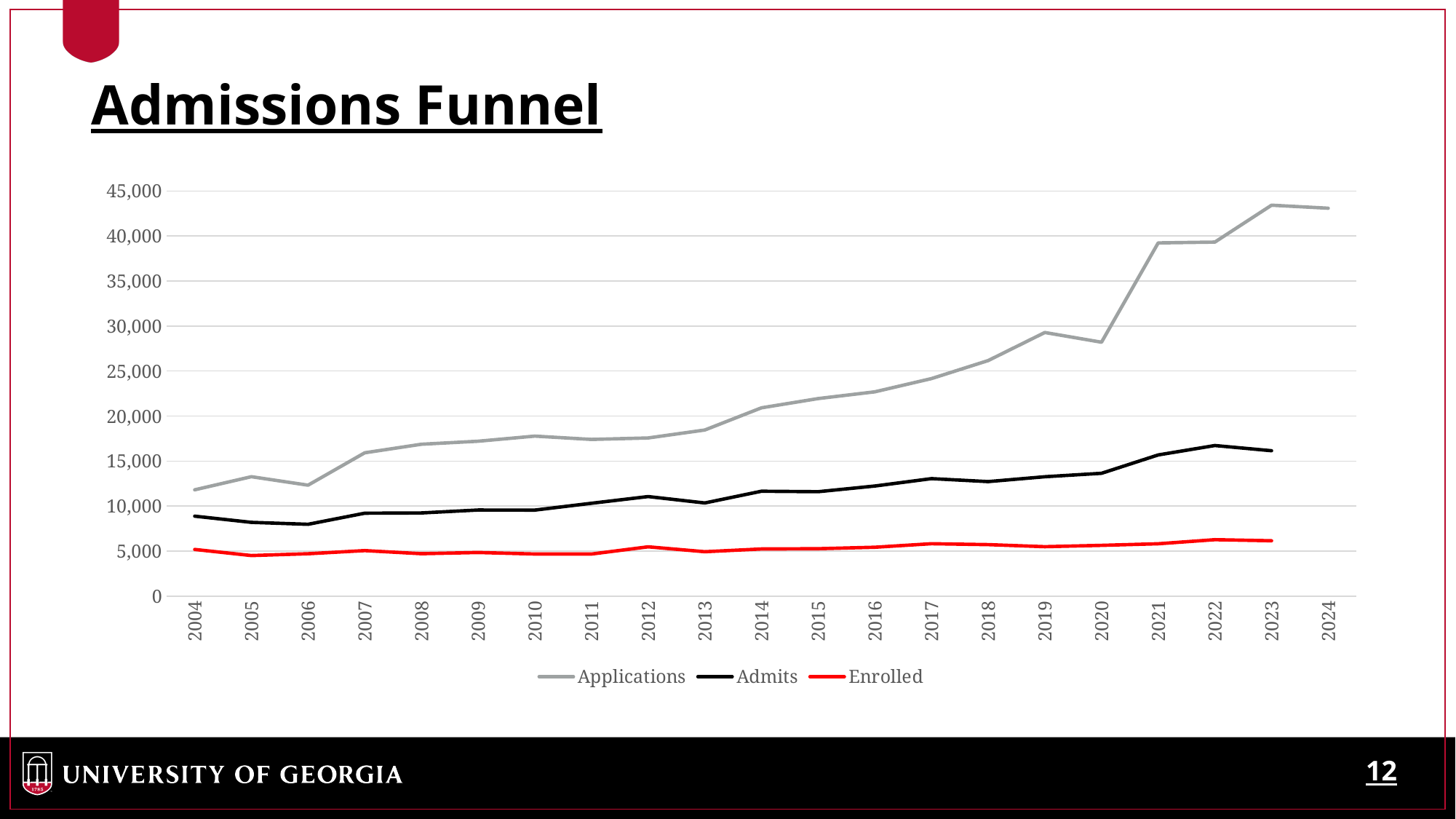
Is the value for Admits in 2023 greater or less than 15,000? greater Is the value for Applications in 2004 greater or less than 15,000? less How many series does the legend list? 3 Which series has the highest values across the chart? Applications What colour is the Enrolled line? red Which is larger, Applications in 2021 or Applications in 2020? Applications in 2021 Do Applications rise or fall overall from 2004 to 2024? rise Is the value for Applications in 2021 greater or less than 35,000? greater Which series has the lowest values across the chart? Enrolled What kind of chart is shown on the slide? line chart How many years are shown on the x axis? 21